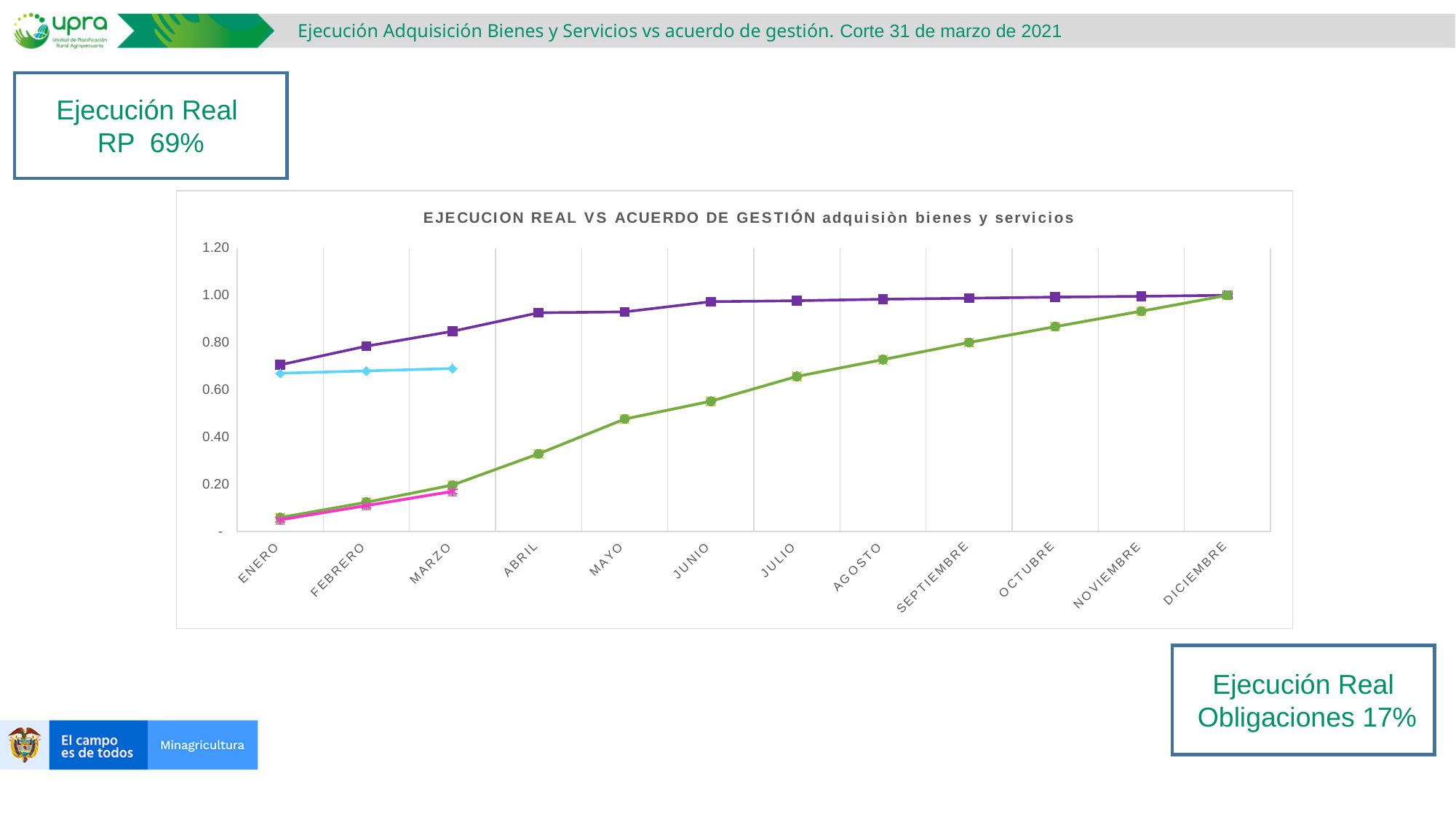
Is the value of the purple line for ENERO greater or less than 0.60? greater Is the value of the green line for ABRIL greater or less than 0.40? less At MARZO, which line has the higher value, the purple line or the green line? purple line What is the title of the chart? EJECUCION REAL VS ACUERDO DE GESTIÓN adquisiòn bienes y servicios Does the green line rise or fall from ENERO to DICIEMBRE? rise In which month does the green line reach its highest value? DICIEMBRE How many months are shown on the x axis of the chart? 12 What kind of chart is shown on the slide? line chart Does the purple line rise or fall from ENERO to DICIEMBRE? rise Is the value of the green line for AGOSTO greater or less than 0.80? less In which month does the purple line have its lowest value? ENERO